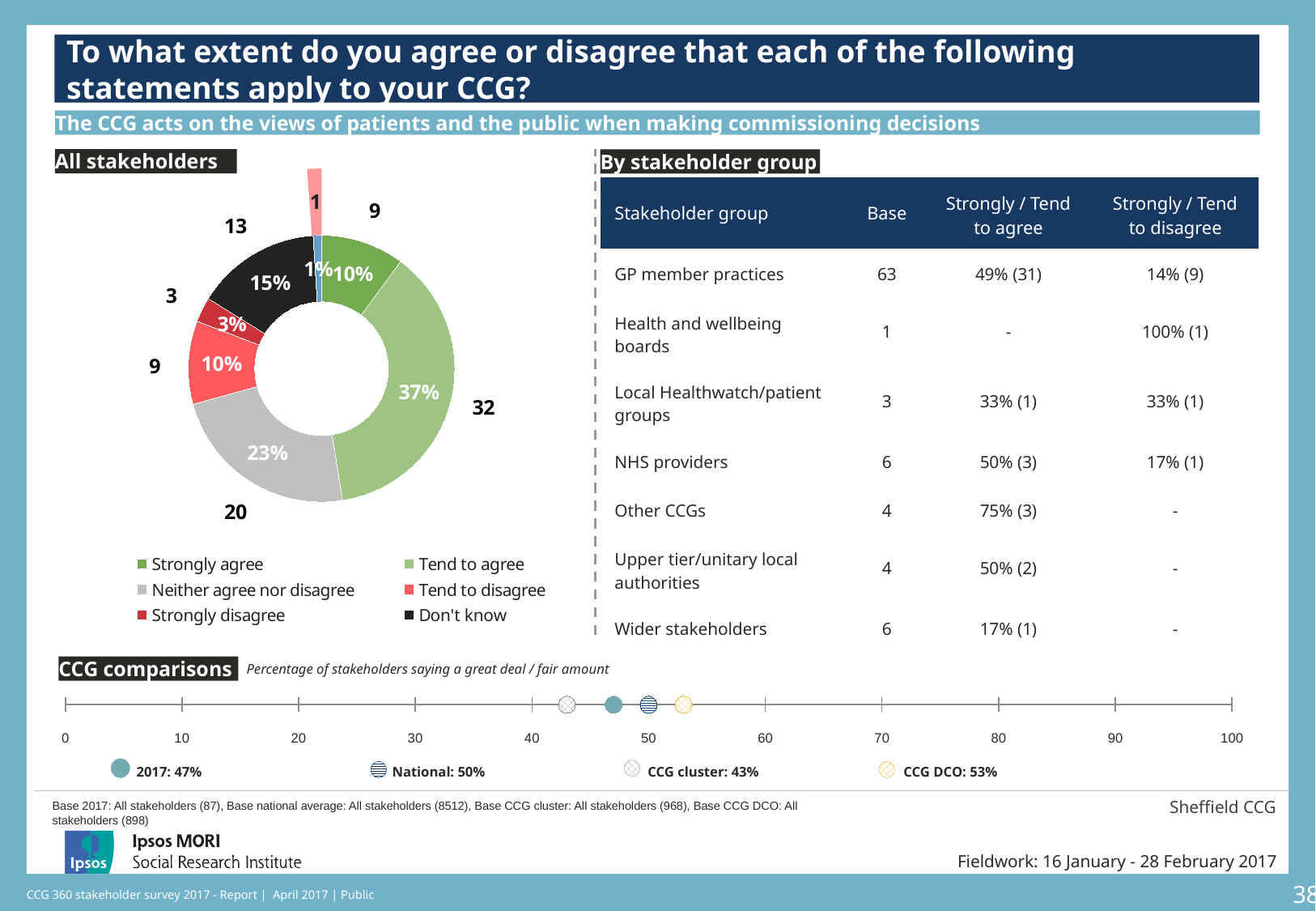
How many entries does the legend of the 'All stakeholders' chart list? 6 In the 'CCG comparisons' chart, what is the difference in percentage points between CCG DCO and CCG cluster? 10 percentage points In the 'All stakeholders' chart, what percentage of stakeholders 'Neither agree nor disagree'? 23% In the 'All stakeholders' chart, which is larger: the share for 'Don't know' or the share for 'Tend to disagree'? Don't know In the 'CCG comparisons' chart, which of the four markers has the highest value? CCG DCO In the 'All stakeholders' chart, what is the difference in percentage points between 'Tend to agree' and 'Strongly agree'? 27 percentage points In the 'All stakeholders' chart, how many respondents are shown for 'Tend to agree'? 32 In the 'CCG comparisons' chart, what is the value for 2017? 47% In the 'All stakeholders' chart, which response category has the largest share? Tend to agree In the 'All stakeholders' chart, what percentage of stakeholders 'Tend to agree'? 37% What kind of chart is the 'All stakeholders' chart? doughnut chart In the 'CCG comparisons' chart, what is the value for the CCG cluster? 43%